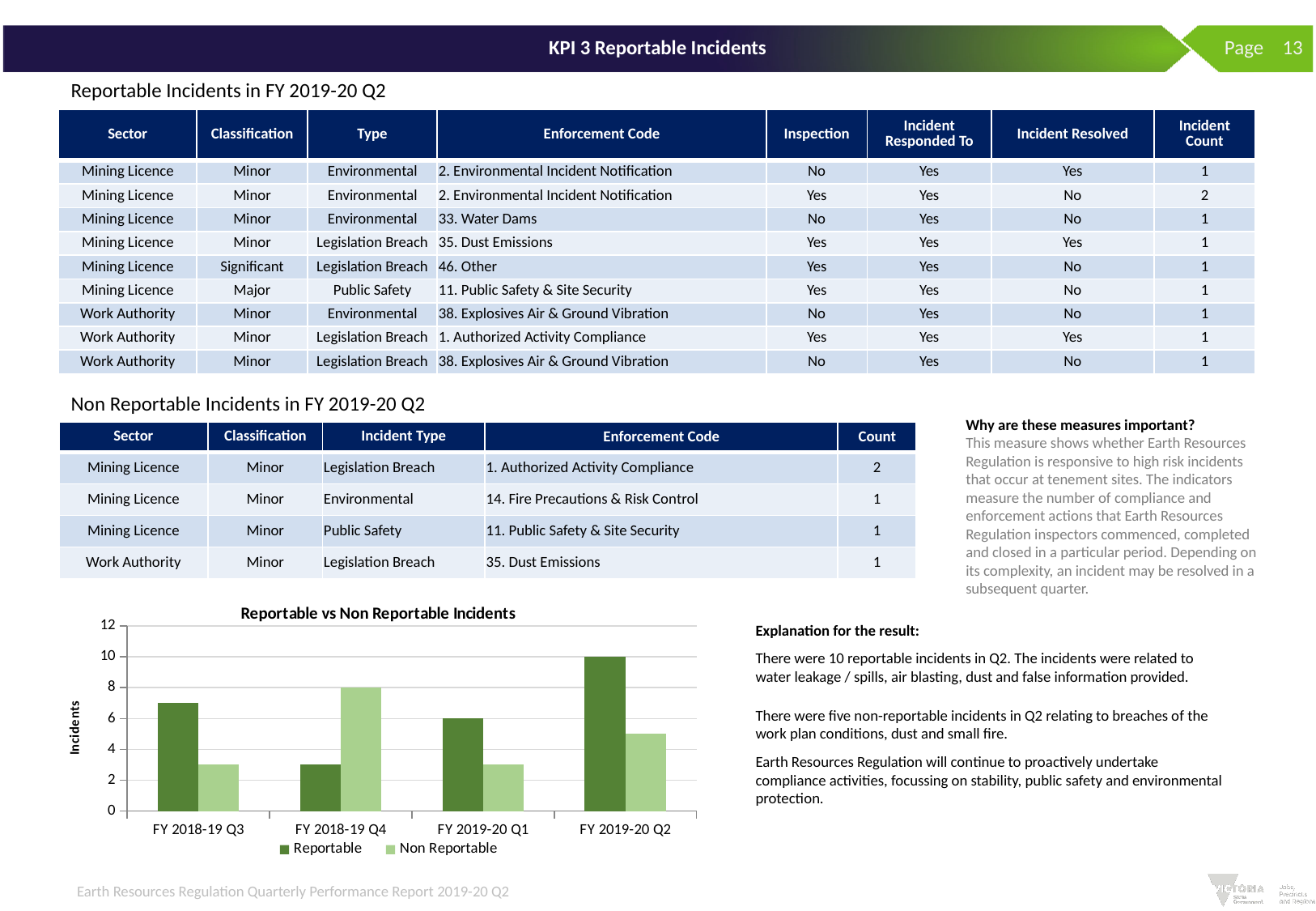
What kind of chart is the 'Reportable vs Non Reportable Incidents' chart? bar chart In the 'Reportable vs Non Reportable Incidents' chart, is the Reportable value for FY 2018-19 Q3 greater or less than 6? greater In the 'Reportable vs Non Reportable Incidents' chart, what is the Non Reportable value for FY 2018-19 Q4? 8 In the 'Reportable vs Non Reportable Incidents' chart, which quarter has the highest Non Reportable value? FY 2018-19 Q4 In the 'Reportable vs Non Reportable Incidents' chart, what is the Reportable value for FY 2019-20 Q1? 6 In the 'Reportable vs Non Reportable Incidents' chart, what is the Reportable value for FY 2019-20 Q2? 10 In the 'Reportable vs Non Reportable Incidents' chart, which quarter has the highest Reportable value? FY 2019-20 Q2 In the 'Reportable vs Non Reportable Incidents' chart, what is the difference between the Reportable values for FY 2019-20 Q2 and FY 2019-20 Q1? 4 In the 'Reportable vs Non Reportable Incidents' chart, which quarter has the lowest Reportable value? FY 2018-19 Q4 How many quarters are shown on the x axis of the 'Reportable vs Non Reportable Incidents' chart? 4 In the 'Reportable vs Non Reportable Incidents' chart, for FY 2018-19 Q4, which is larger: Reportable or Non Reportable? Non Reportable How many series does the legend of the 'Reportable vs Non Reportable Incidents' chart list? 2